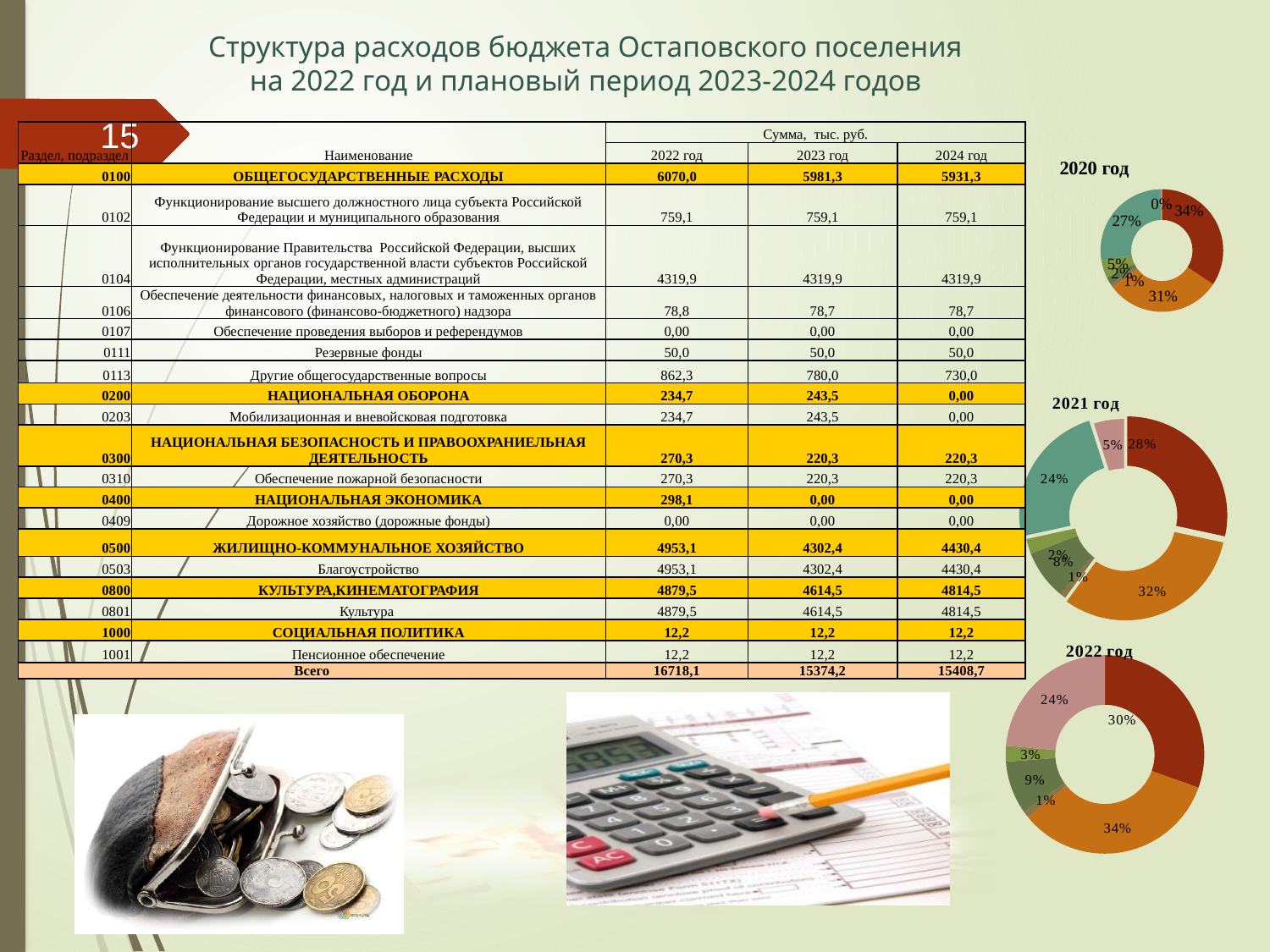
What kind of chart is the '2022 год' chart? doughnut chart In the '2020 год' chart, what is the share of the largest slice? 34% In the '2022 год' chart, what is the share of the largest slice? 34% In the '2022 год' chart, what is the share of the pink slice? 24% In the '2022 год' chart, what is the share of the smallest labelled slice? 1% In the '2022 год' chart, what is the difference in percentage points between the two largest slices (34% and 30%)? 4 percentage points How many charts are shown on the slide? 3 What are the titles of the three charts on the slide? 2020 год, 2021 год, 2022 год In the '2021 год' chart, what is the share of the largest slice? 32% How many slices does the '2022 год' chart have? 6 How many slices does the '2021 год' chart have? 7 Which chart has the larger biggest slice, '2021 год' or '2022 год'? 2022 год